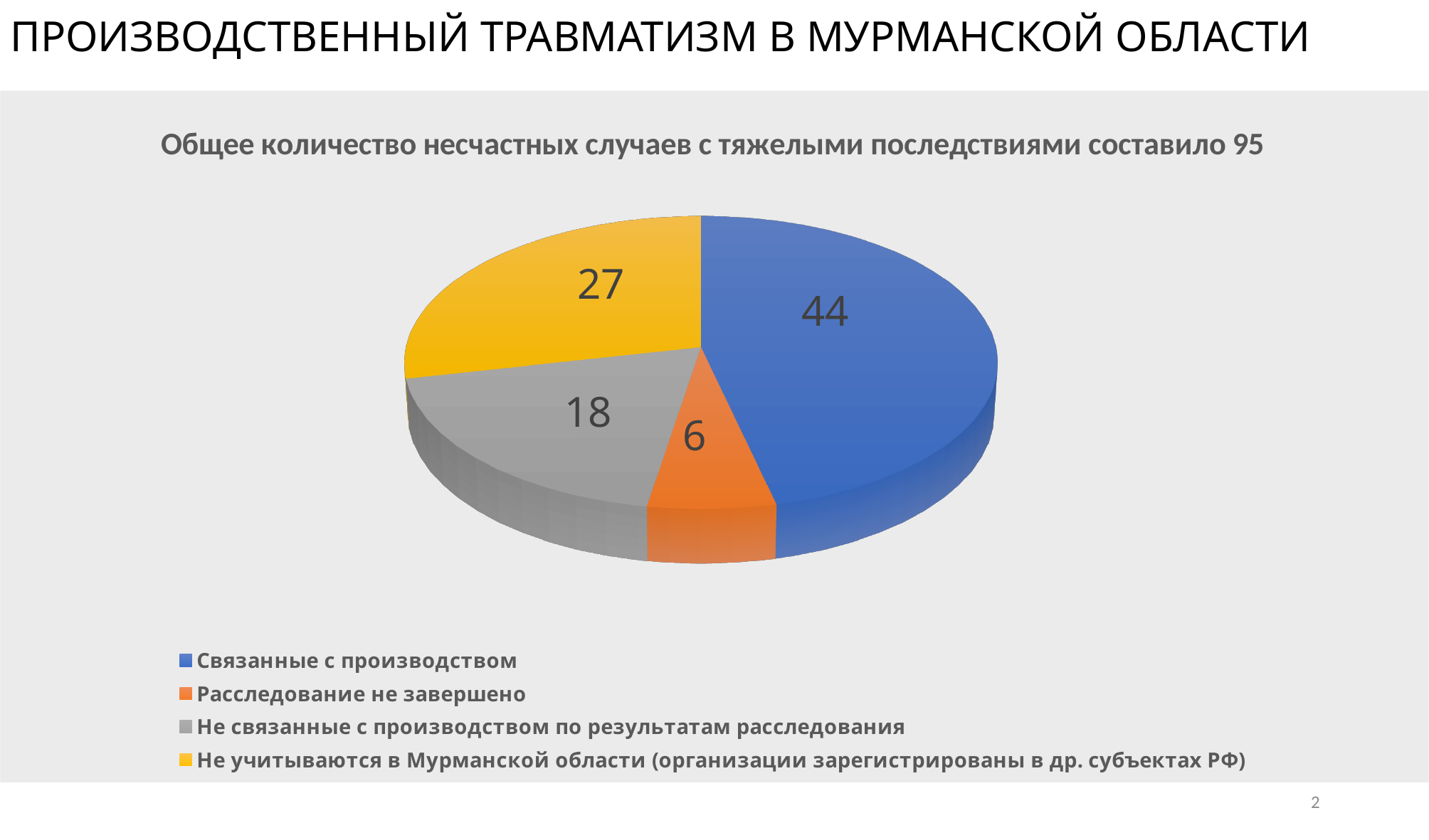
Which category has the largest slice of the pie? Связанные с производством What type of chart is shown on the slide? Pie chart Which is larger: the value for "Не связанные с производством по результатам расследования" or the value for "Не учитываются в Мурманской области (организации зарегистрированы в др. субъектах РФ)"? Не учитываются в Мурманской области (организации зарегистрированы в др. субъектах РФ) What is the value for "Расследование не завершено"? 6 How many slices does the pie chart have? 4 What is the value for "Связанные с производством"? 44 What is the value for "Не связанные с производством по результатам расследования"? 18 What colour is the slice for "Расследование не завершено"? Orange What is the difference between the values for "Связанные с производством" and "Не учитываются в Мурманской области (организации зарегистрированы в др. субъектах РФ)"? 17 What is the total of all slices in the pie chart? 95 Which category has the smallest slice of the pie? Расследование не завершено What is the value for "Не учитываются в Мурманской области (организации зарегистрированы в др. субъектах РФ)"? 27